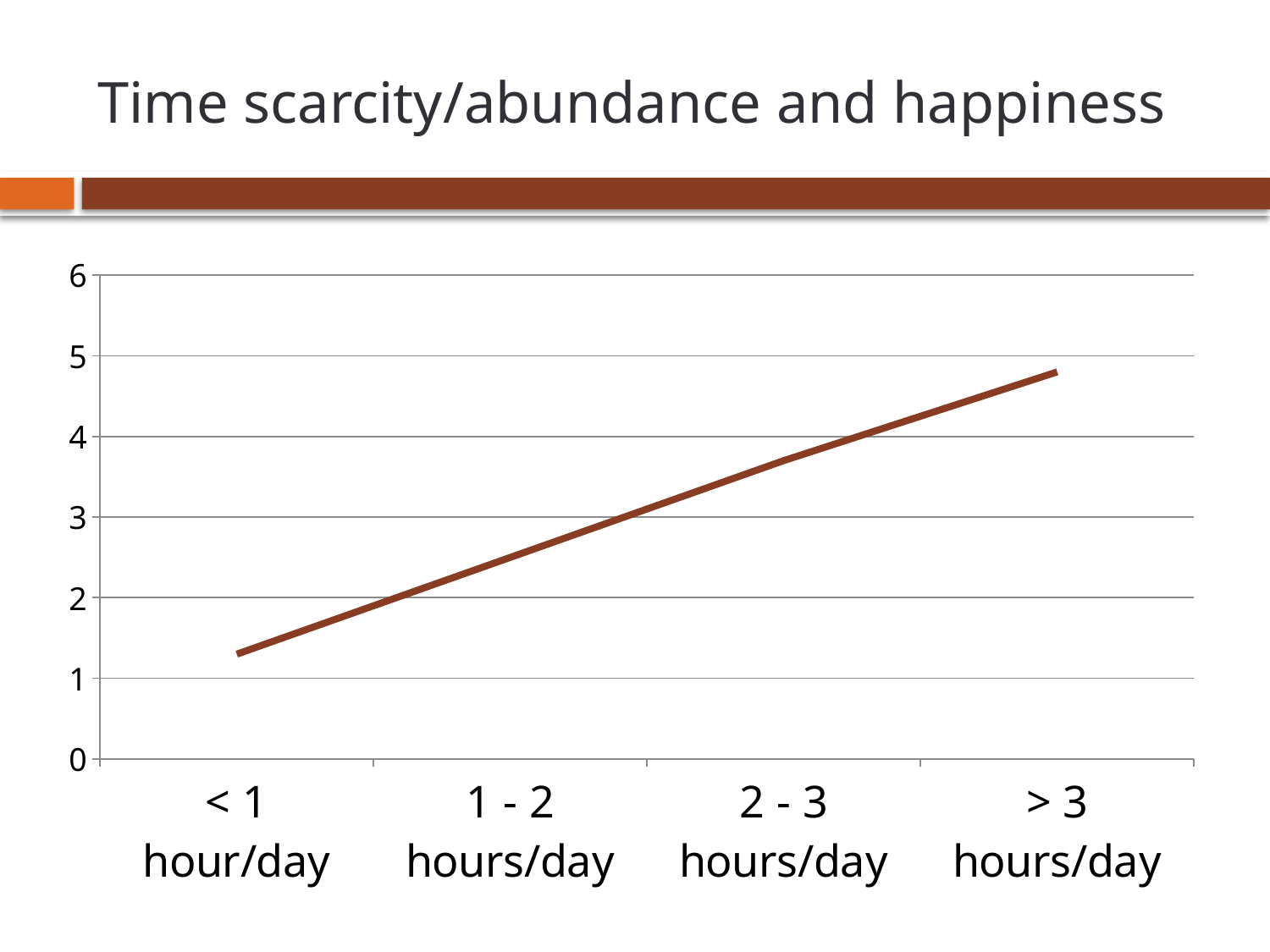
What is the title of the slide? Time scarcity/abundance and happiness Which category has the lowest value? < 1 hour/day Is the value for > 3 hours/day greater or less than 4? greater What is the highest value shown on the y axis? 6 Is the value for 1 - 2 hours/day greater or less than 3? less Which category has the highest value? > 3 hours/day What kind of chart is shown on the slide? line chart Do the values rise or fall as you move from left to right along the x axis? rise Is the value for 2 - 3 hours/day greater or less than 3? greater Which is larger, the value for 1 - 2 hours/day or the value for 2 - 3 hours/day? 2 - 3 hours/day How many categories are shown on the x axis? 4